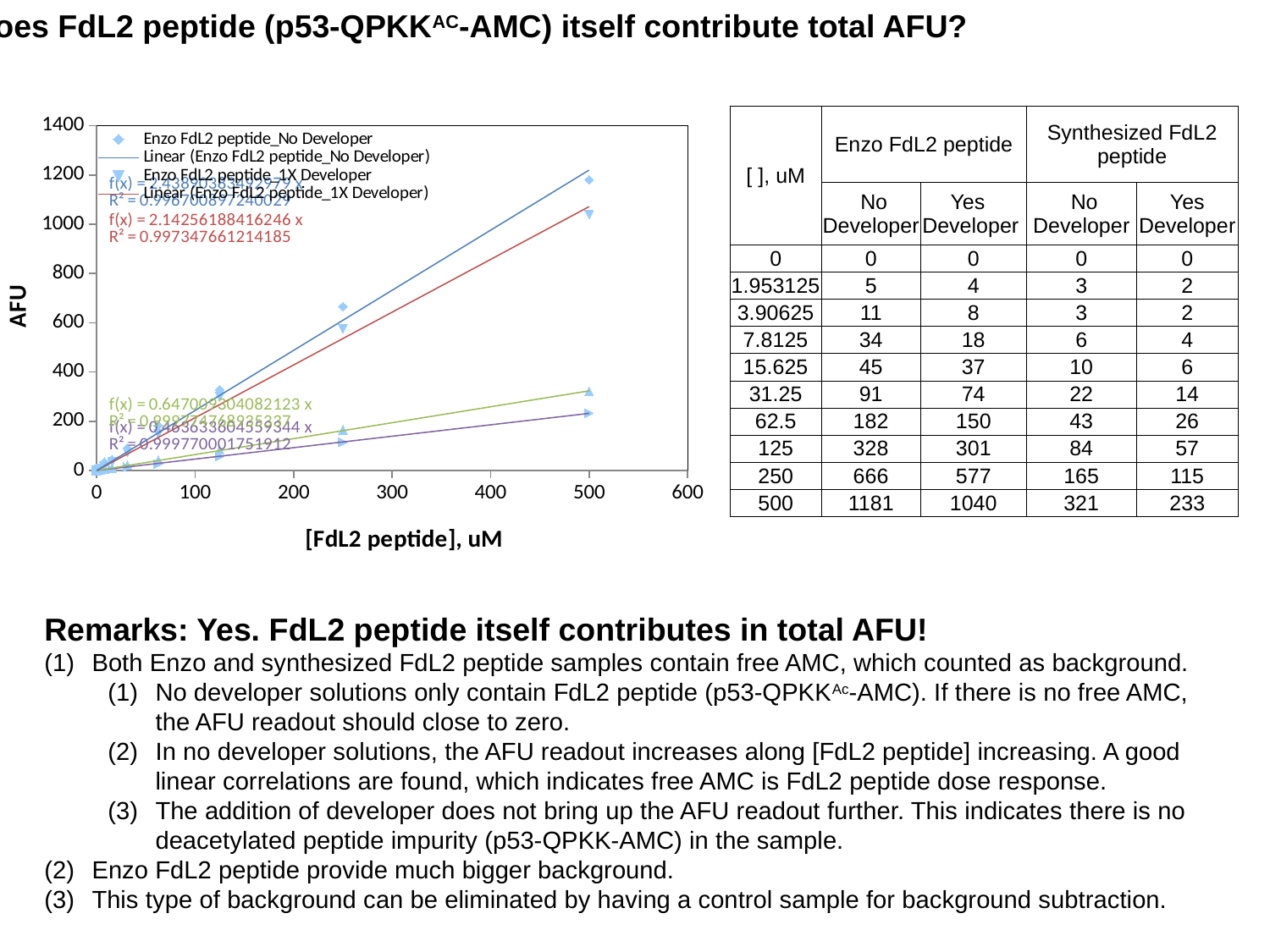
Is the AFU value for Synthesized FdL2 peptide with No Developer at 500 uM greater or less than 400? less What is the label of the y axis of the chart? AFU Is the AFU value for Enzo FdL2 peptide with No Developer at 500 uM greater or less than 1000? greater At 250 uM, which has the larger AFU: Enzo FdL2 peptide No Developer or Synthesized FdL2 peptide No Developer? Enzo FdL2 peptide No Developer How many concentration points are listed in the table, including 0 uM? 10 What is the difference in AFU between Enzo FdL2 peptide No Developer and Yes Developer at 500 uM, using the table values? 141 What is the label of the x axis of the chart? [FdL2 peptide], uM According to the table on the slide, what is the AFU for Enzo FdL2 peptide with No Developer at 500 uM? 1181 What kind of chart is shown on the slide? Scatter chart with linear trendlines Does the AFU readout rise or fall as [FdL2 peptide] increases along the x axis? Rises According to the table on the slide, what is the AFU for Synthesized FdL2 peptide with Yes Developer at 250 uM? 115 Which sample gives the highest AFU at 500 uM? Enzo FdL2 peptide, No Developer